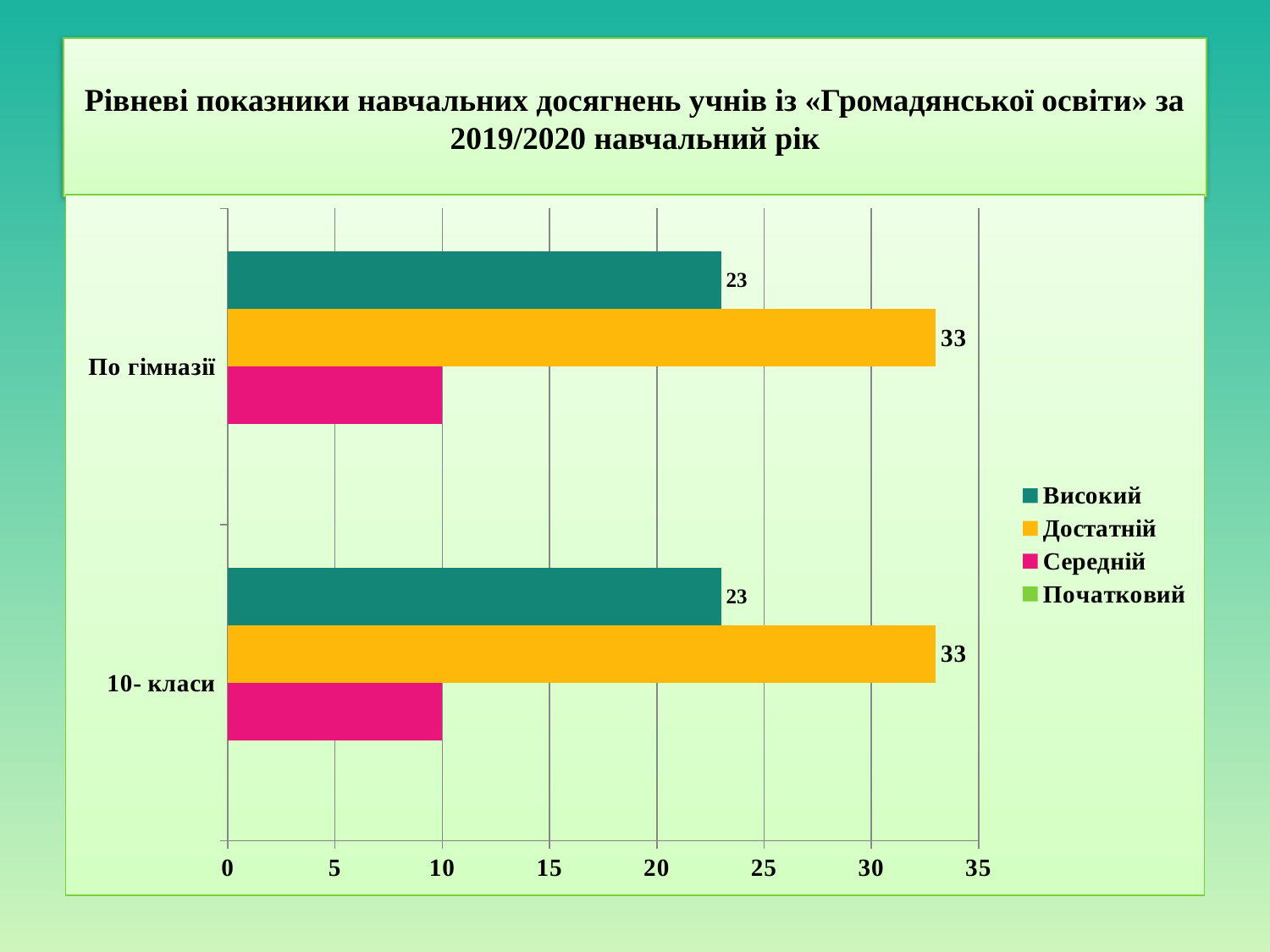
What colour represents the Достатній series in the legend? yellow How many categories are shown on the vertical axis? 2 What is the value of Достатній for 10- класи? 33 What type of chart is shown on the slide? bar chart What is the difference between Достатній and Високий for По гімназії? 10 Which plotted series has the lowest value for По гімназії? Середній How many series does the legend list? 4 For 10- класи, which is larger: Високий or Середній? Високий Which series has the highest value for 10- класи? Достатній Is the value of Достатній for 10- класи greater or less than 30? greater What is the value of Середній for По гімназії? 10 What is the value of Високий for По гімназії? 23